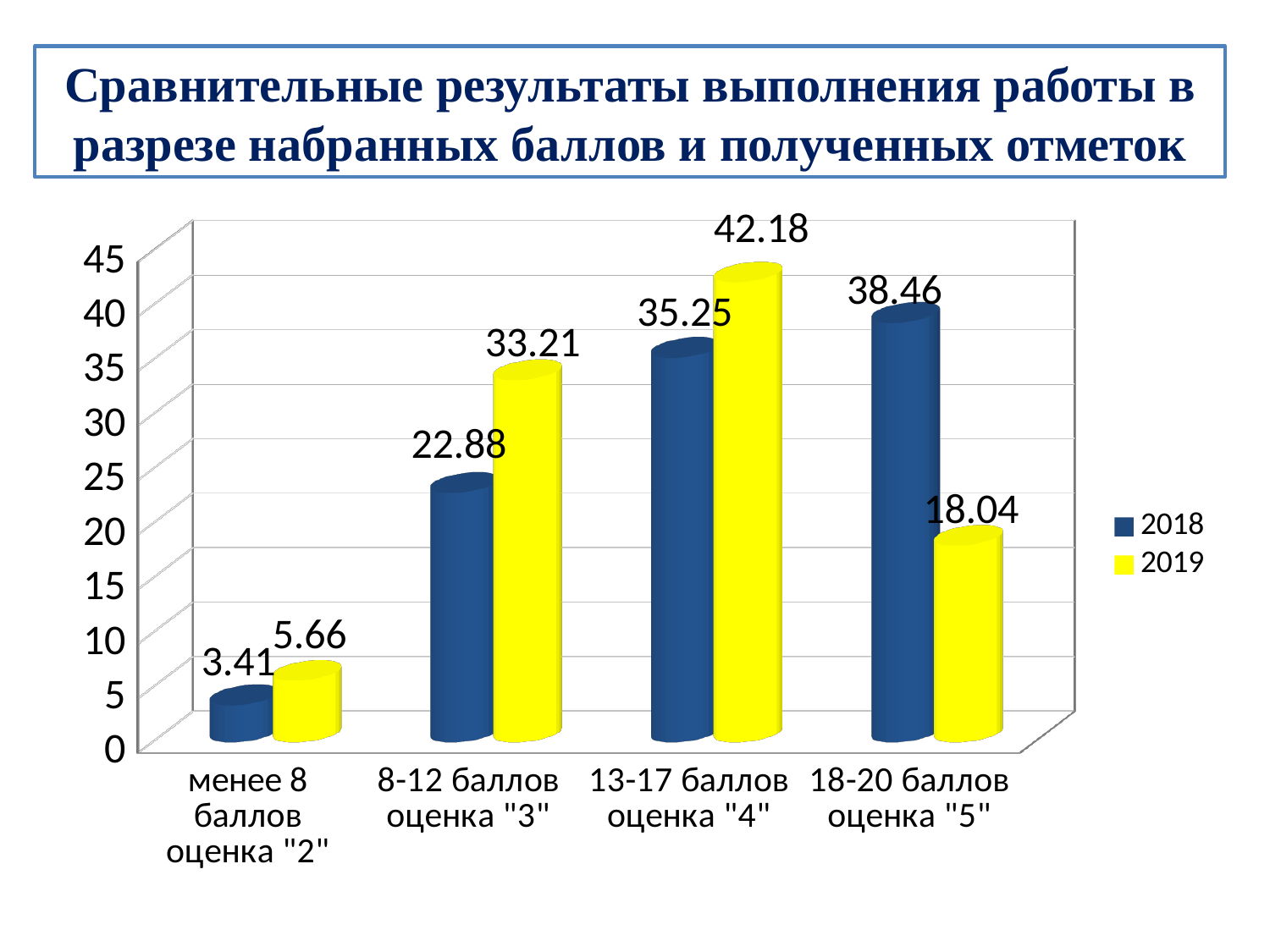
Which category has the highest 2018 value? 18-20 баллов оценка "5" Is the 2018 value for 13-17 баллов оценка "4" greater or less than 30? greater How many categories are shown on the x axis? 4 What is the 2018 value for the category 8-12 баллов оценка "3"? 22.88 What kind of chart is shown on the slide? bar chart What is the 2019 value for the category 13-17 баллов оценка "4"? 42.18 For the category 18-20 баллов оценка "5", which series has the larger value, 2018 or 2019? 2018 How many series does the legend list? 2 What is the difference between the 2019 and 2018 values for 8-12 баллов оценка "3"? 10.33 Which category has the lowest 2019 value? менее 8 баллов оценка "2" Which colour represents the 2019 series in the legend? yellow What is the 2019 value for the category 18-20 баллов оценка "5"? 18.04